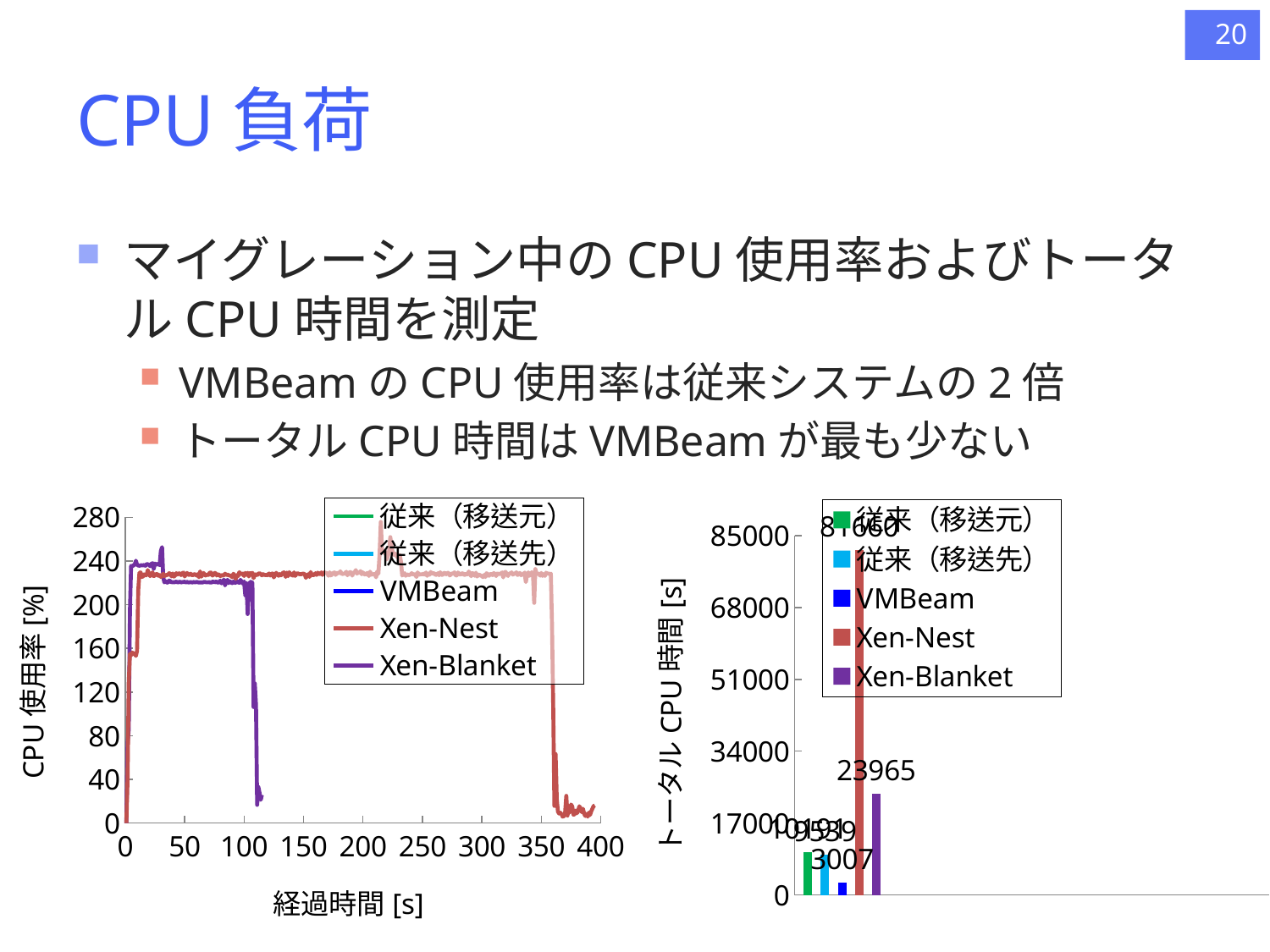
In the left chart (CPU 使用率), what is the label of the x axis? 経過時間 [s] In the left chart (CPU 使用率), is the Xen-Nest value at 200 s greater or less than 200? greater In the right chart (トータル CPU 時間), how many series does the legend list? 5 In the right chart (トータル CPU 時間), what is the value for VMBeam? 3007 In the right chart (トータル CPU 時間), what is the difference between the Xen-Blanket value and the VMBeam value? 20958 In the right chart (トータル CPU 時間), what is the value for Xen-Nest? 81660 In the right chart (トータル CPU 時間), what is the difference between the Xen-Nest value and the Xen-Blanket value? 57695 What kind of chart is the chart on the right of the slide (トータル CPU 時間)? bar chart In the right chart (トータル CPU 時間), what is the value for Xen-Blanket? 23965 In the right chart (トータル CPU 時間), which system has the lowest total CPU time? VMBeam What kind of chart is the chart on the left of the slide (CPU 使用率 vs 経過時間)? line chart In the right chart (トータル CPU 時間), which system has the highest total CPU time? Xen-Nest